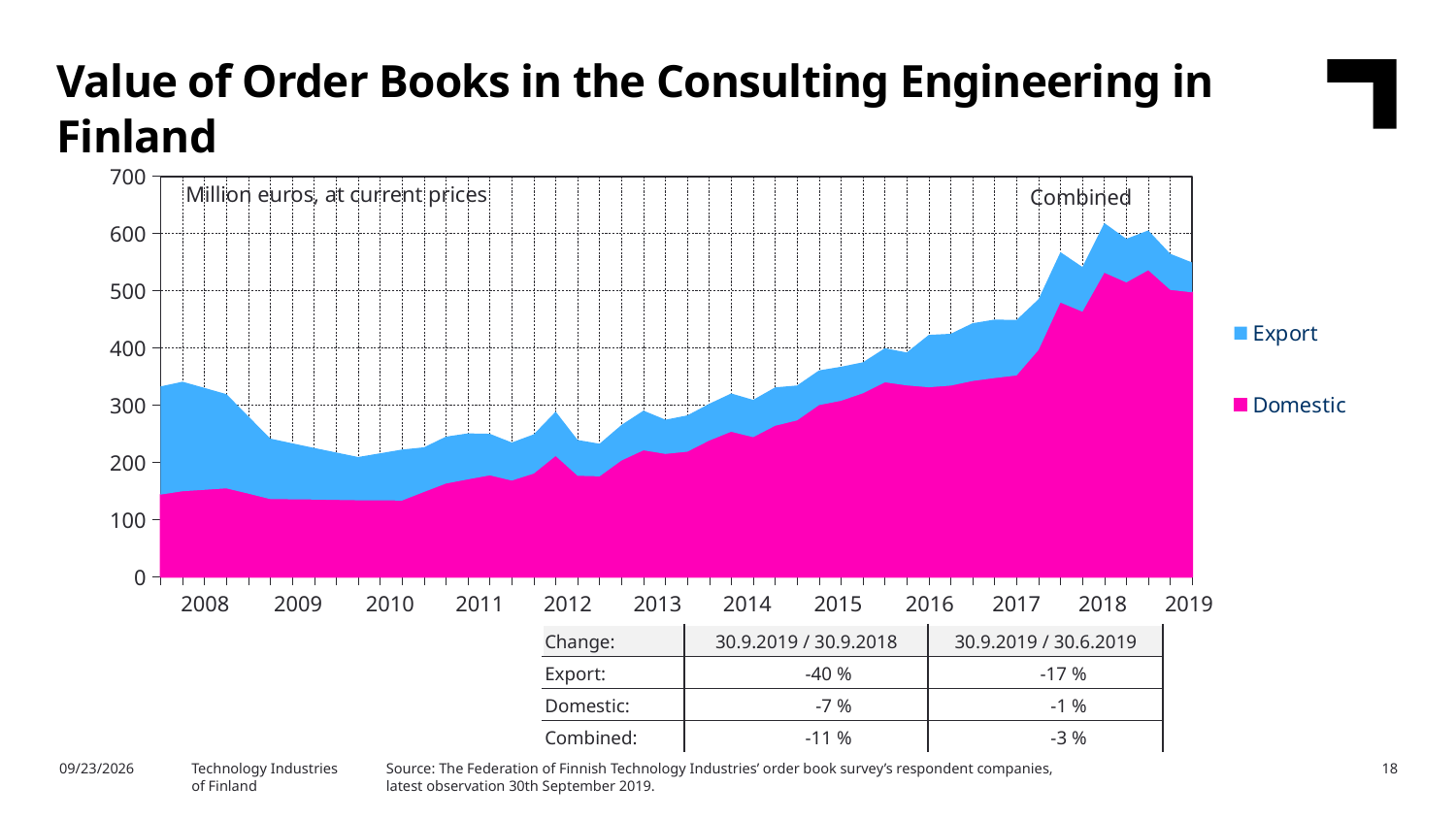
According to the table below the chart, what is the change in Combined order books from 30.6.2019 to 30.9.2019? -3 % Is the combined value at the start of 2008 greater or less than 300? greater Does the combined value of order books rise or fall between 2012 and 2018? rise Which series, Domestic or Export, has the larger value at the end of 2019? Domestic Which two series are listed in the chart's legend? Export and Domestic What unit is stated in the chart for the values? Million euros, at current prices Is the Domestic value at the start of 2010 greater or less than 200? less According to the table below the chart, what is the change in Export order books from 30.9.2018 to 30.9.2019? -40 % Is the combined value at the end of 2019 greater or less than 500? greater What kind of chart is shown on the slide? Stacked area chart How many series does the chart's legend list? 2 How many year labels appear on the x axis of the chart? 12